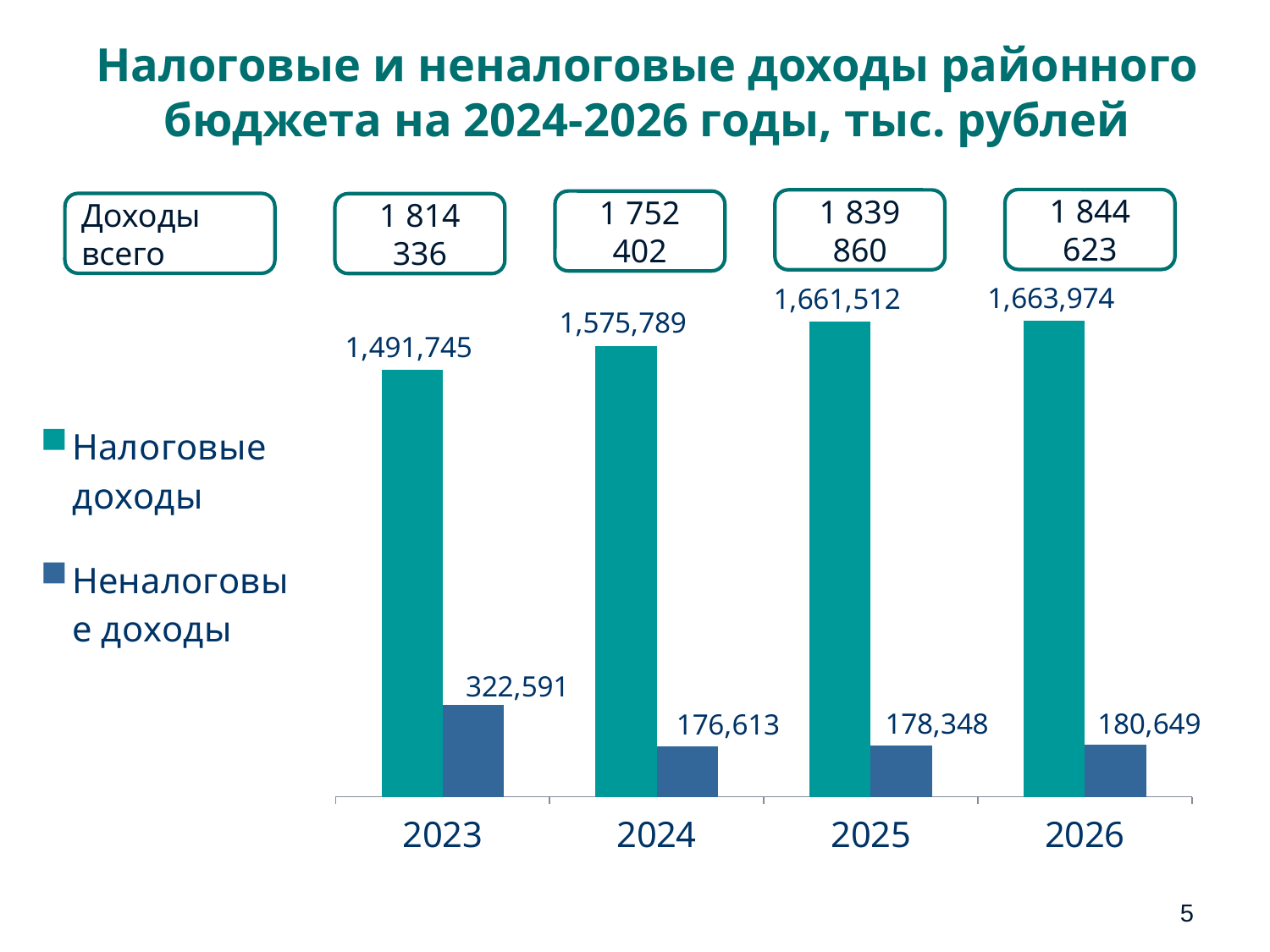
What is the value of Налоговые доходы for 2023? 1,491,745 Do the values of Налоговые доходы rise or fall from 2023 to 2026? rise What is the difference between Налоговые доходы and Неналоговые доходы in 2023? 1,169,154 What is the value of Неналоговые доходы for 2026? 180,649 Which is larger: Неналоговые доходы in 2025 or in 2026? 2026 How many years are shown on the x axis? 4 In which year is Неналоговые доходы the lowest? 2024 In which year is Налоговые доходы the highest? 2026 By how much did Неналоговые доходы decrease from 2023 to 2024? 145,978 How many series does the legend list? 2 What is the value of Неналоговые доходы for 2024? 176,613 What is the value of Налоговые доходы for 2025? 1,661,512